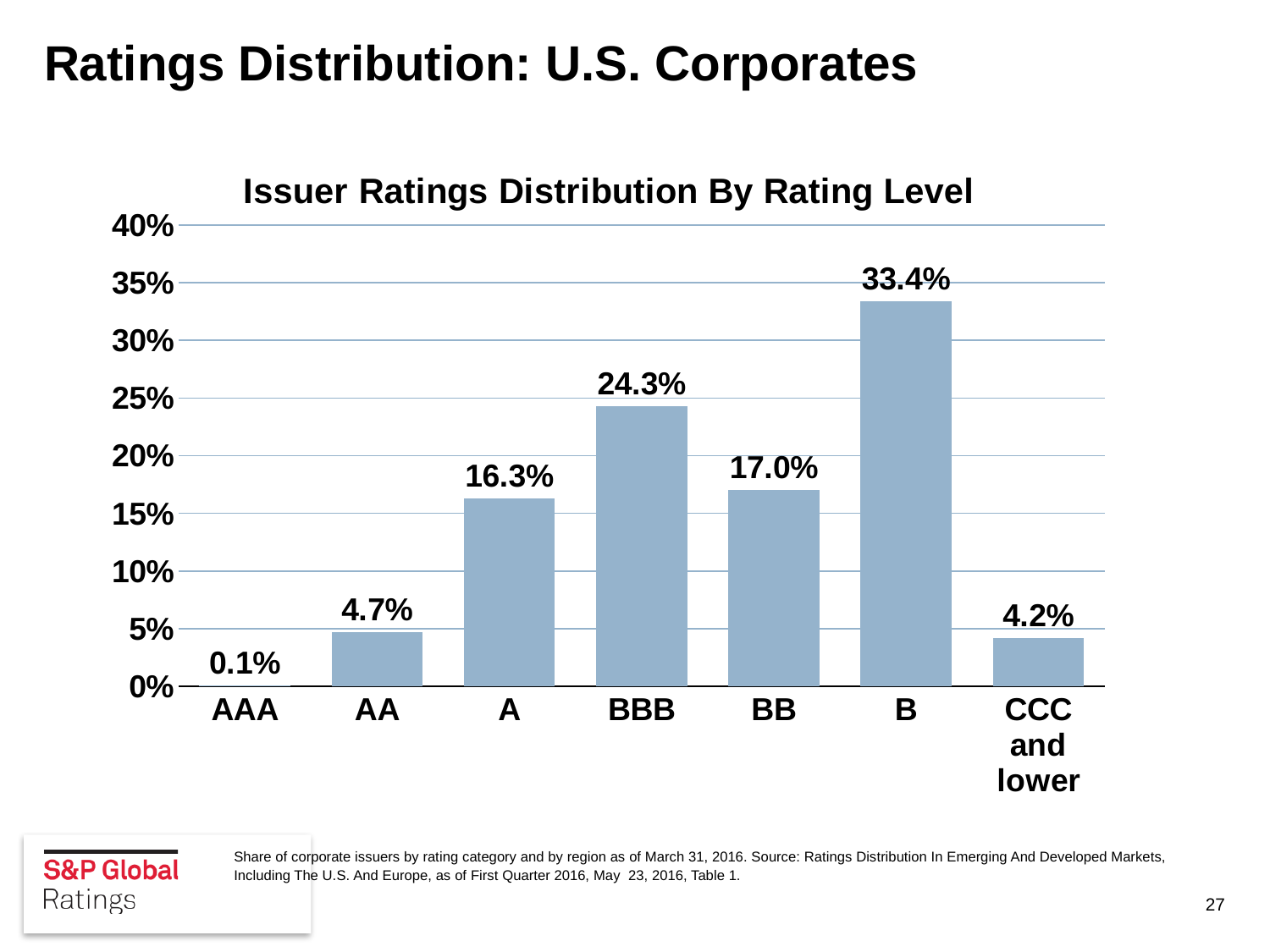
What is the difference between the values for BB and A? 0.7% Which is larger, the value for AA or the value for CCC and lower? AA What is the difference between the values for B and BBB? 9.1% What kind of chart is shown on the slide? Bar chart Which rating category has the lowest share of issuers? AAA How many rating categories are shown on the x axis? 7 What is the value for the AAA rating category? 0.1% What is the value for the BBB rating category? 24.3% Which rating category has the highest share of issuers? B What is the title of the chart? Issuer Ratings Distribution By Rating Level What is the value for the B rating category? 33.4% What is the value for the CCC and lower category? 4.2%